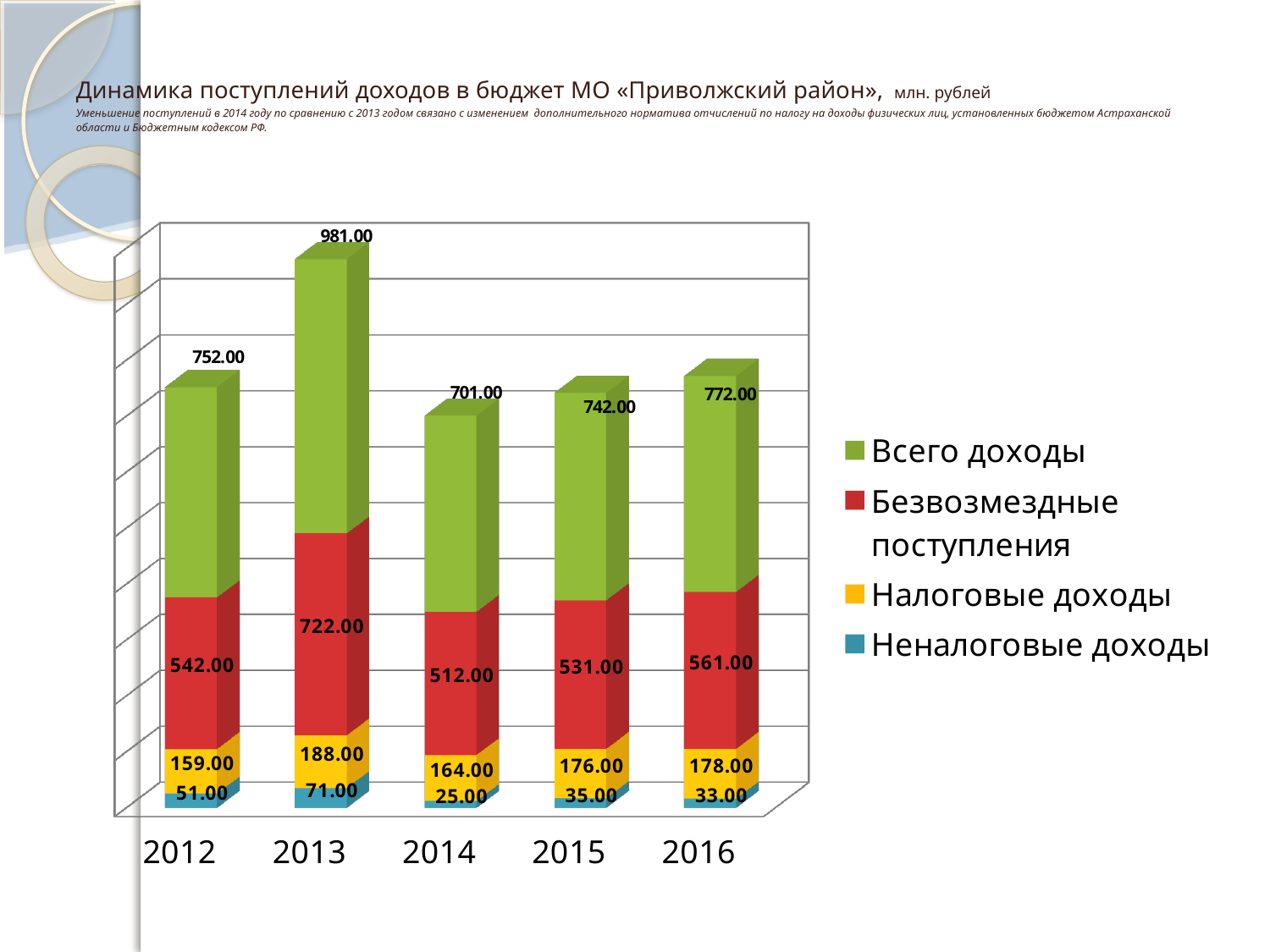
What is the value of Неналоговые доходы for 2014? 25.00 How many years are shown on the x axis? 5 What is the value of Налоговые доходы for 2016? 178.00 What is the difference between Всего доходы in 2013 and in 2014? 280.00 What kind of chart is shown on the slide? Stacked bar chart Which is larger: Налоговые доходы in 2012 or in 2015? 2015 Which colour represents Налоговые доходы in the legend? Yellow In which year is Всего доходы the highest? 2013 In which year is Неналоговые доходы the lowest? 2014 What is the value of Всего доходы for 2015? 742.00 How many series does the legend list? 4 What is the value of Безвозмездные поступления for 2013? 722.00